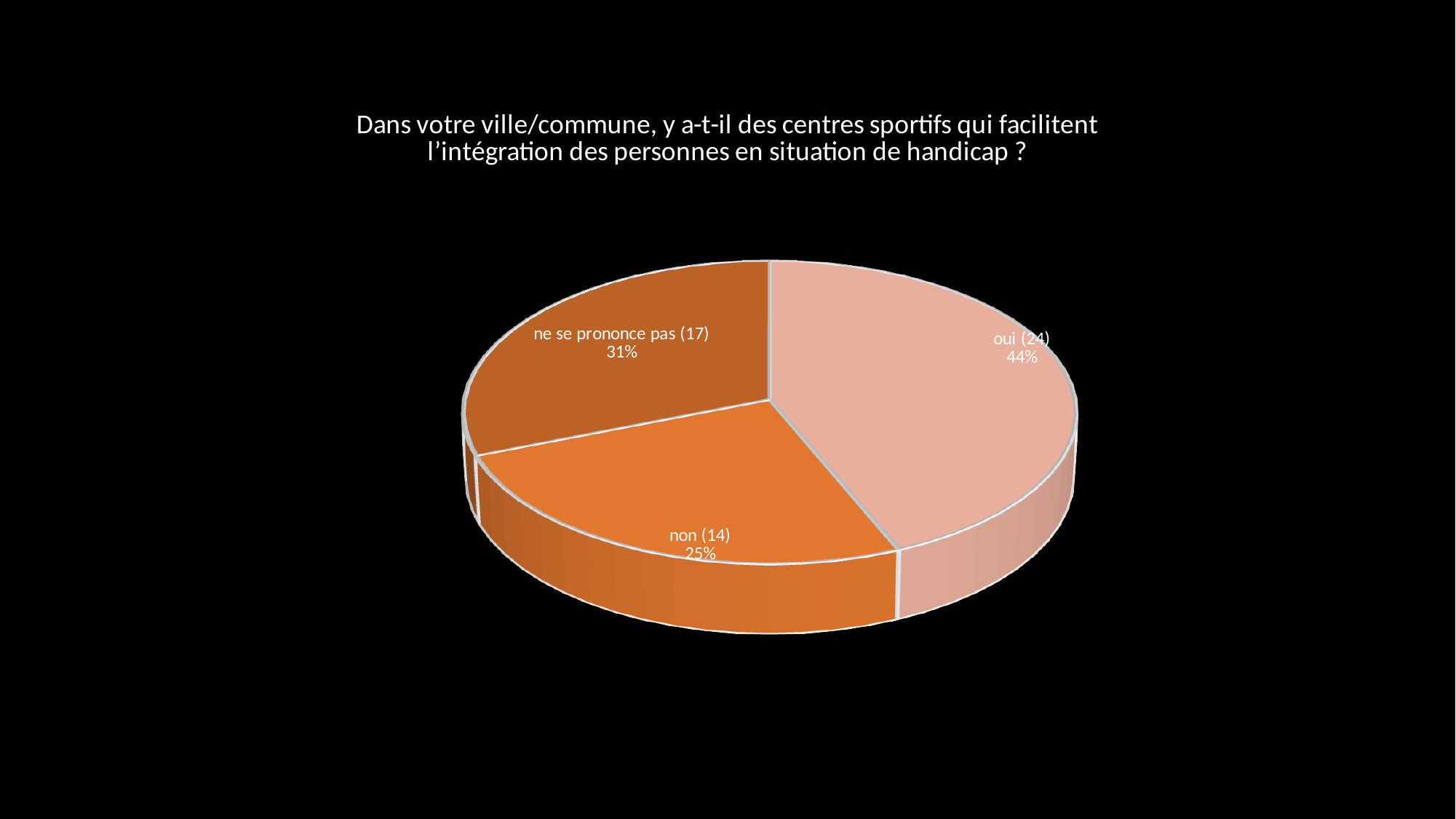
What percentage of the pie does the "ne se prononce pas" slice represent? 31% Which has more respondents, "ne se prononce pas" or "non"? ne se prononce pas What is the difference in number of respondents between "oui" and "non"? 10 How many respondents answered "non"? 14 What percentage of the pie does the "oui" slice represent? 44% Which response has the smallest slice of the pie? non How many respondents answered "ne se prononce pas"? 17 Which response has the largest slice of the pie? oui What percentage of the pie does the "non" slice represent? 25% How many slices does the pie chart have? 3 What kind of chart is shown on the slide? pie chart How many respondents answered "oui"? 24